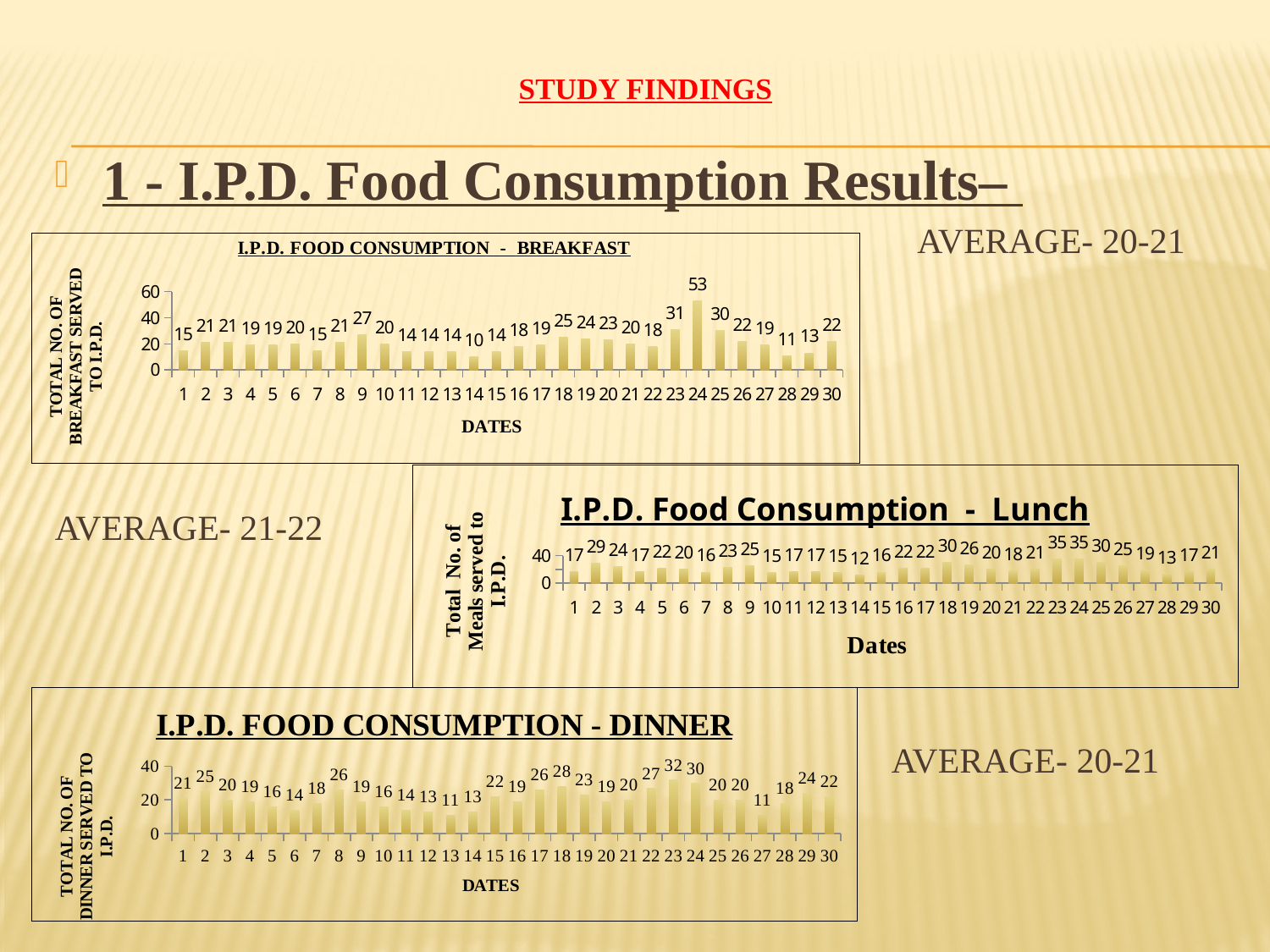
What type of chart is the I.P.D. Food Consumption - Lunch chart? bar chart In the I.P.D. Food Consumption - Lunch chart, which date has the lowest value? 14 In the I.P.D. Food Consumption - Lunch chart, which is larger, the value for date 18 or the value for date 19? date 18 In the I.P.D. Food Consumption - Dinner chart, what is the difference between the values for date 8 and date 6? 12 In the I.P.D. Food Consumption - Dinner chart, what is the value for date 23? 32 In the I.P.D. Food Consumption - Breakfast chart, which date has the lowest value? 14 In the I.P.D. Food Consumption - Breakfast chart, what is the value for date 24? 53 In the I.P.D. Food Consumption - Lunch chart, what is the value for date 2? 29 In the I.P.D. Food Consumption - Breakfast chart, what is the difference between the values for date 24 and date 23? 22 What is the x-axis title of the I.P.D. Food Consumption - Breakfast chart? DATES How many dates are plotted in the I.P.D. Food Consumption - Dinner chart? 30 In the I.P.D. Food Consumption - Dinner chart, which date has the highest value? 23